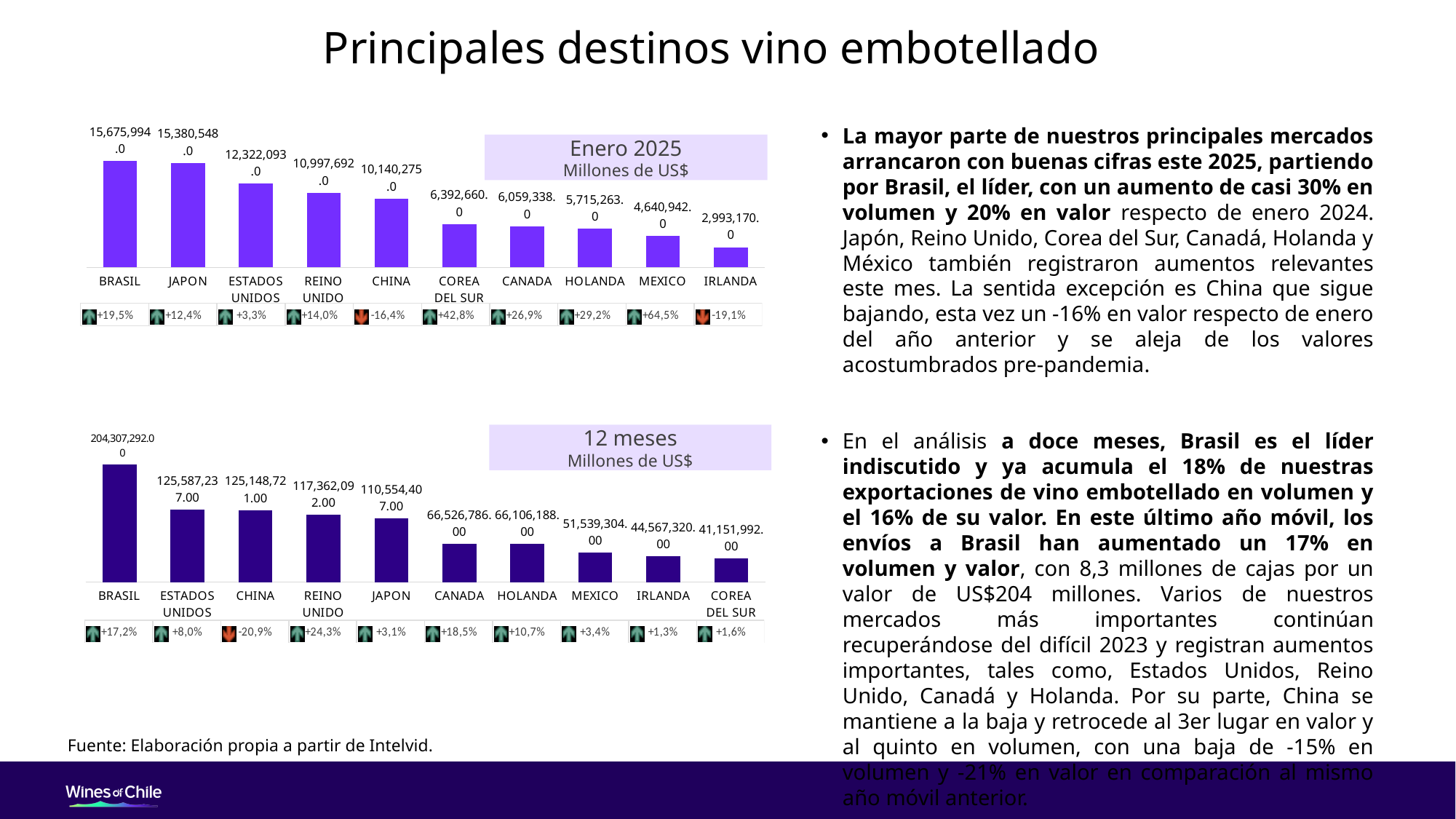
In the 12 meses chart, which is larger, the value for REINO UNIDO or the value for JAPON? REINO UNIDO In the 12 meses chart, which destination has the highest value? BRASIL In the 12 meses chart, what is the difference between the values for CANADA and HOLANDA? 420,598.00 In the Enero 2025 chart, what is the value for BRASIL? 15,675,994.0 In the Enero 2025 chart, which destination has the lowest value? IRLANDA In the Enero 2025 chart, what is the difference between the values for BRASIL and JAPON? 295,446.0 In the Enero 2025 chart, what percentage change is shown below CHINA? -16,4% What type of chart is the 12 meses chart? Bar chart In the Enero 2025 chart, how many destinations are shown? 10 In the Enero 2025 chart, what is the value for COREA DEL SUR? 6,392,660.0 In the 12 meses chart, what is the value for MEXICO? 51,539,304.00 In the 12 meses chart, what is the value for BRASIL? 204,307,292.00